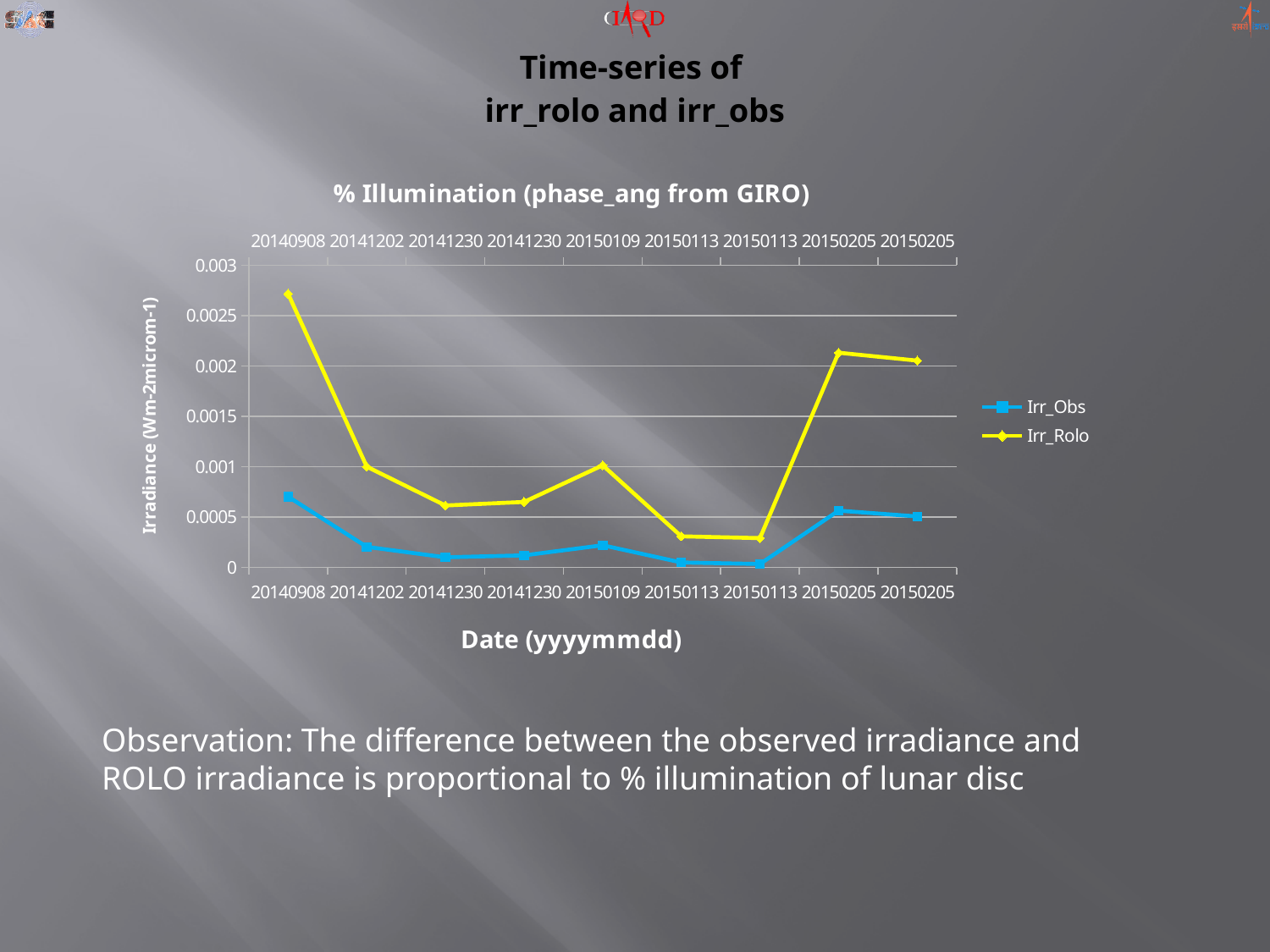
At which date does the Irr_Obs series reach its highest value? 20140908 How many date points are plotted along the x axis? 9 How many series does the legend list? 2 Is the Irr_Rolo value at the first 20150205 point greater or less than 0.002? greater What are the two series named in the legend? Irr_Obs and Irr_Rolo What is the label of the y axis? Irradiance (Wm-2microm-1) What kind of chart is shown on the slide? line chart Does the Irr_Rolo series rise or fall between 20140908 and 20141202? fall At which date does the Irr_Rolo series reach its highest value? 20140908 Is the Irr_Rolo value at 20140908 greater or less than 0.0025? greater At 20140908, which series has the larger value, Irr_Obs or Irr_Rolo? Irr_Rolo Is the Irr_Obs value at 20141230 greater or less than 0.0005? less